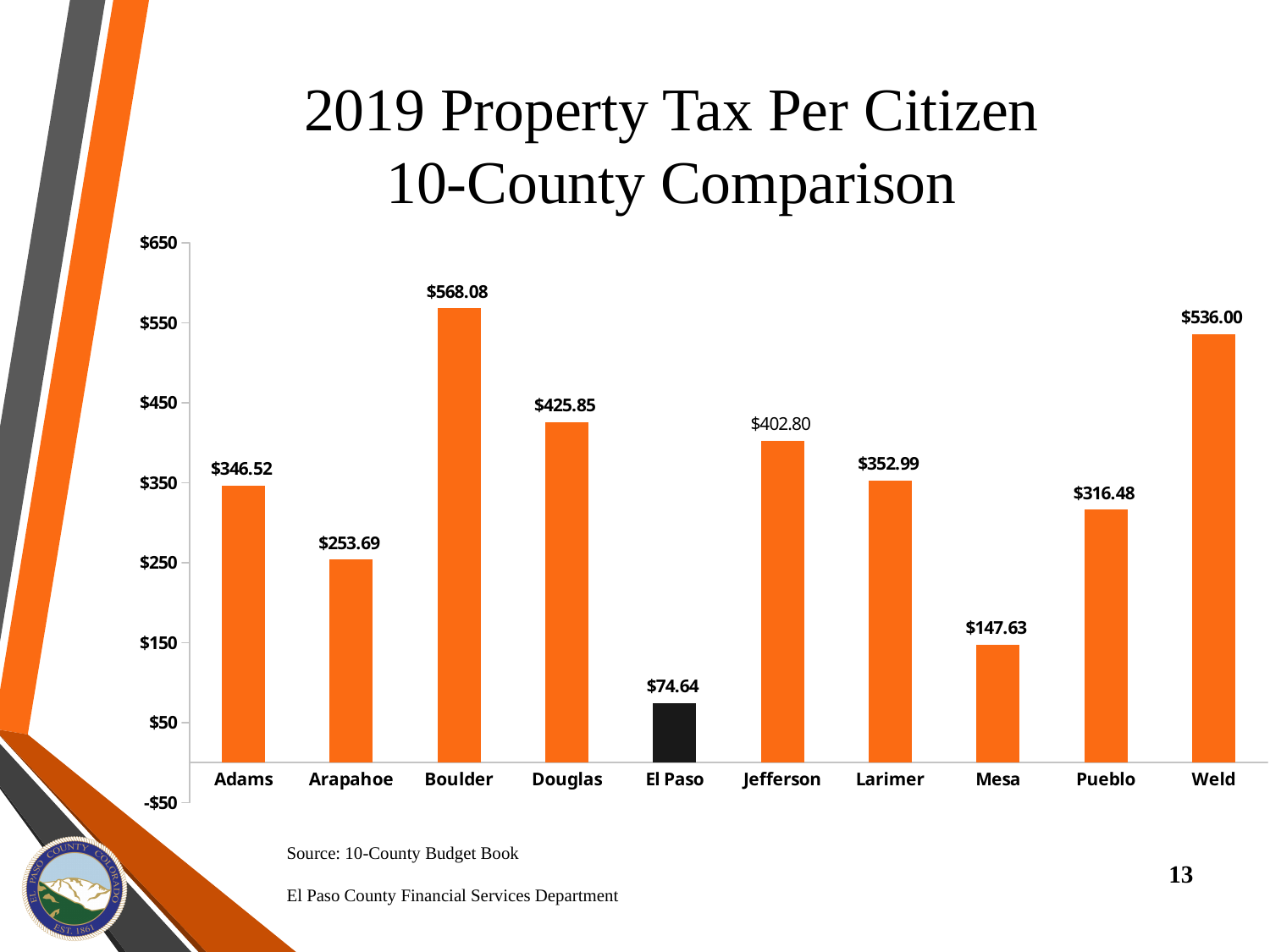
What kind of chart is shown on the slide? Bar chart What is the 2019 property tax per citizen for Boulder? $568.08 Which county's bar is coloured black instead of orange? El Paso What is the difference between Boulder's and El Paso's property tax per citizen? $493.44 What is the 2019 property tax per citizen for Jefferson? $402.80 Which county has the highest property tax per citizen? Boulder How many counties are shown in the chart? 10 Is the value for Weld greater or less than $450? greater What is the 2019 property tax per citizen for El Paso? $74.64 Which county has the lowest property tax per citizen? El Paso What is the difference between Adams's and Arapahoe's property tax per citizen? $92.83 Which has a higher property tax per citizen, Douglas or Larimer? Douglas